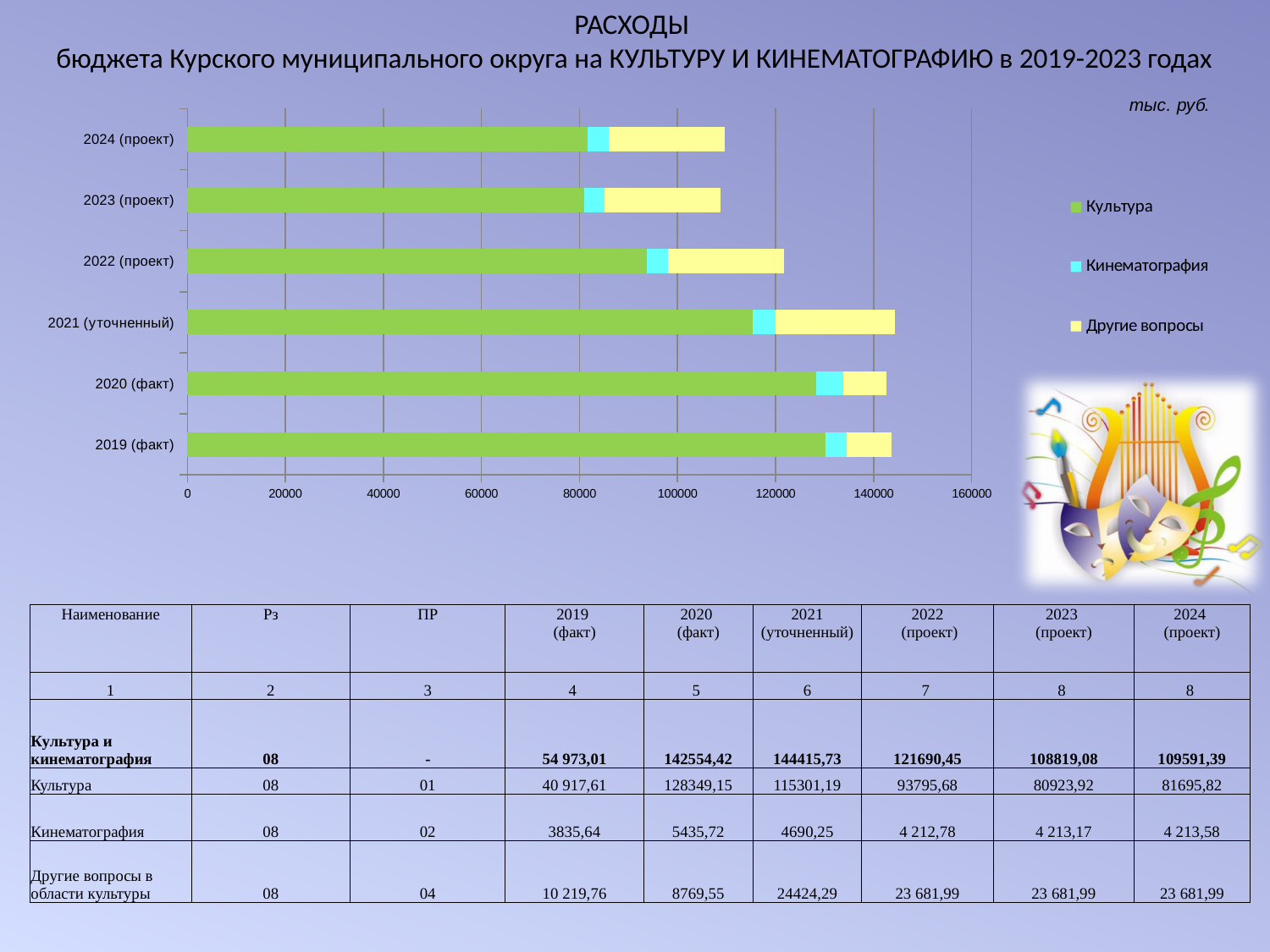
How many series does the chart legend list? 3 How many year categories are plotted on the chart? 6 Is the Культура value for 2021 (уточненный) greater or less than 100000? greater Does the Культура value rise or fall from 2020 (факт) to 2023 (проект)? fall According to the table on the slide, what is the Культура value for 2021 (уточненный)? 115301,19 Which colour represents Культура in the chart legend? green Which is larger, the Культура value for 2021 (уточненный) or for 2022 (проект)? 2021 (уточненный) Is the total bar for 2023 (проект) greater or less than 100000? greater Is the Культура value for 2024 (проект) greater or less than 100000? less According to the table on the slide, what is the total for Культура и кинематография in 2022 (проект)? 121690,45 What kind of chart is shown on the slide? stacked bar chart